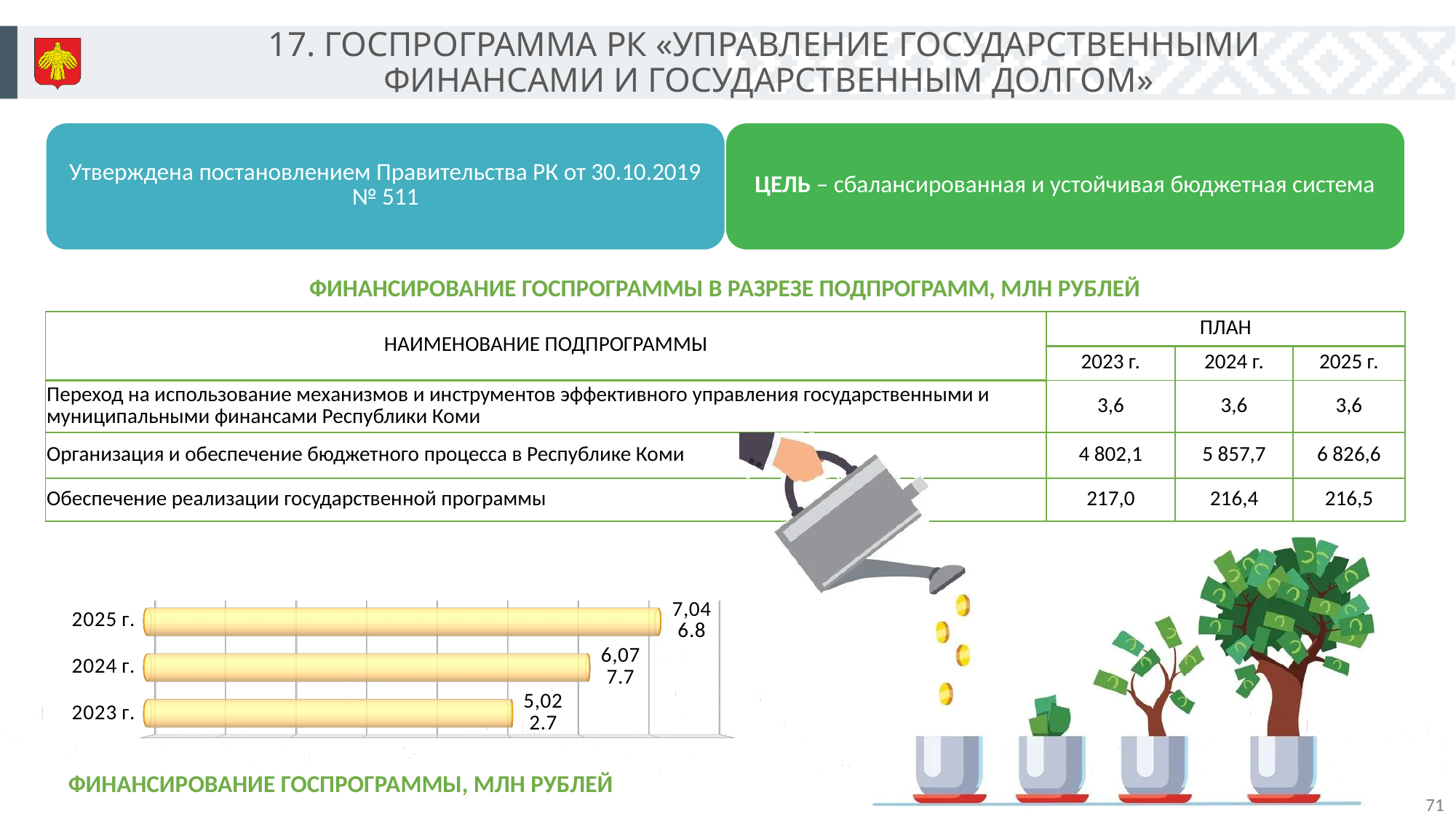
Is the bar for 2025 г. longer or shorter than the bar for 2024 г.? longer Do the bar values increase or decrease from 2023 г. to 2025 г.? increase What is the data label on the bar for 2023 г.? 5,022.7 Is the bar for 2024 г. longer or shorter than the bar for 2023 г.? longer Which year has the longest bar in the chart? 2025 г. What is the title of the bar chart? ФИНАНСИРОВАНИЕ ГОСПРОГРАММЫ, МЛН РУБЛЕЙ What kind of chart is shown at the bottom left of the slide? bar chart Which year has the shortest bar in the chart? 2023 г. What colour are the bars in the chart? yellow What is the data label on the bar for 2025 г.? 7,046.8 How many categories (years) does the bar chart show? 3